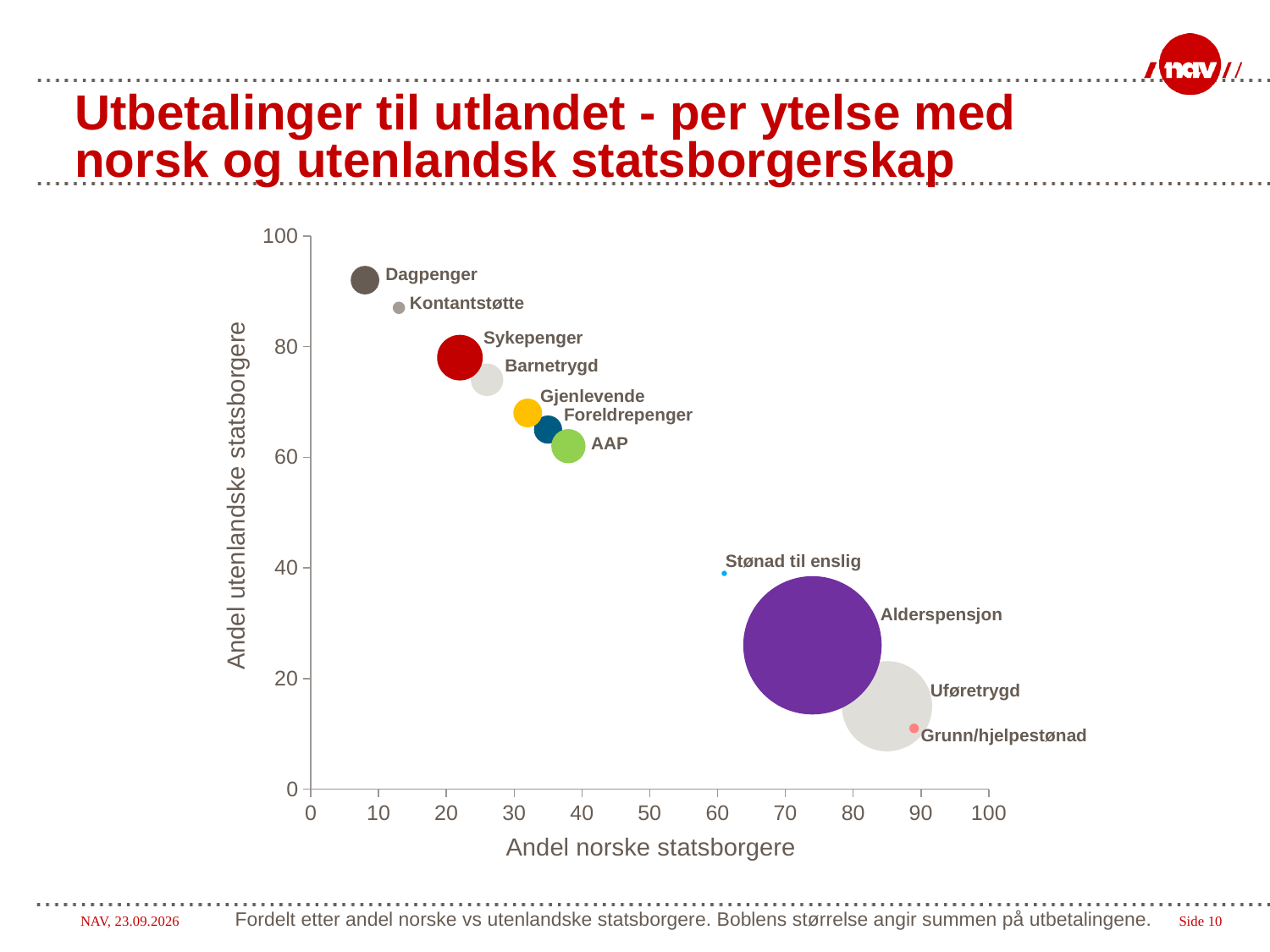
Is the share of foreign citizens for Uføretrygd greater or less than 20? less As the share of Norwegian citizens (x axis) increases, does the share of foreign citizens rise or fall? Fall What is the title of the x axis of the chart? Andel norske statsborgere How many benefits (bubbles) are plotted in the chart? 11 What kind of chart is shown on the slide? Bubble chart Is the share of Norwegian citizens for Alderspensjon greater or less than 70? greater Which benefit has the largest bubble in the chart? Alderspensjon Which has a higher share of Norwegian citizens, Uføretrygd or Sykepenger? Uføretrygd Which benefit has the lowest share of foreign citizens (Andel utenlandske statsborgere)? Grunn/hjelpestønad Is the share of Norwegian citizens for Sykepenger greater or less than 30? less Which benefit has the highest share of foreign citizens (Andel utenlandske statsborgere)? Dagpenger